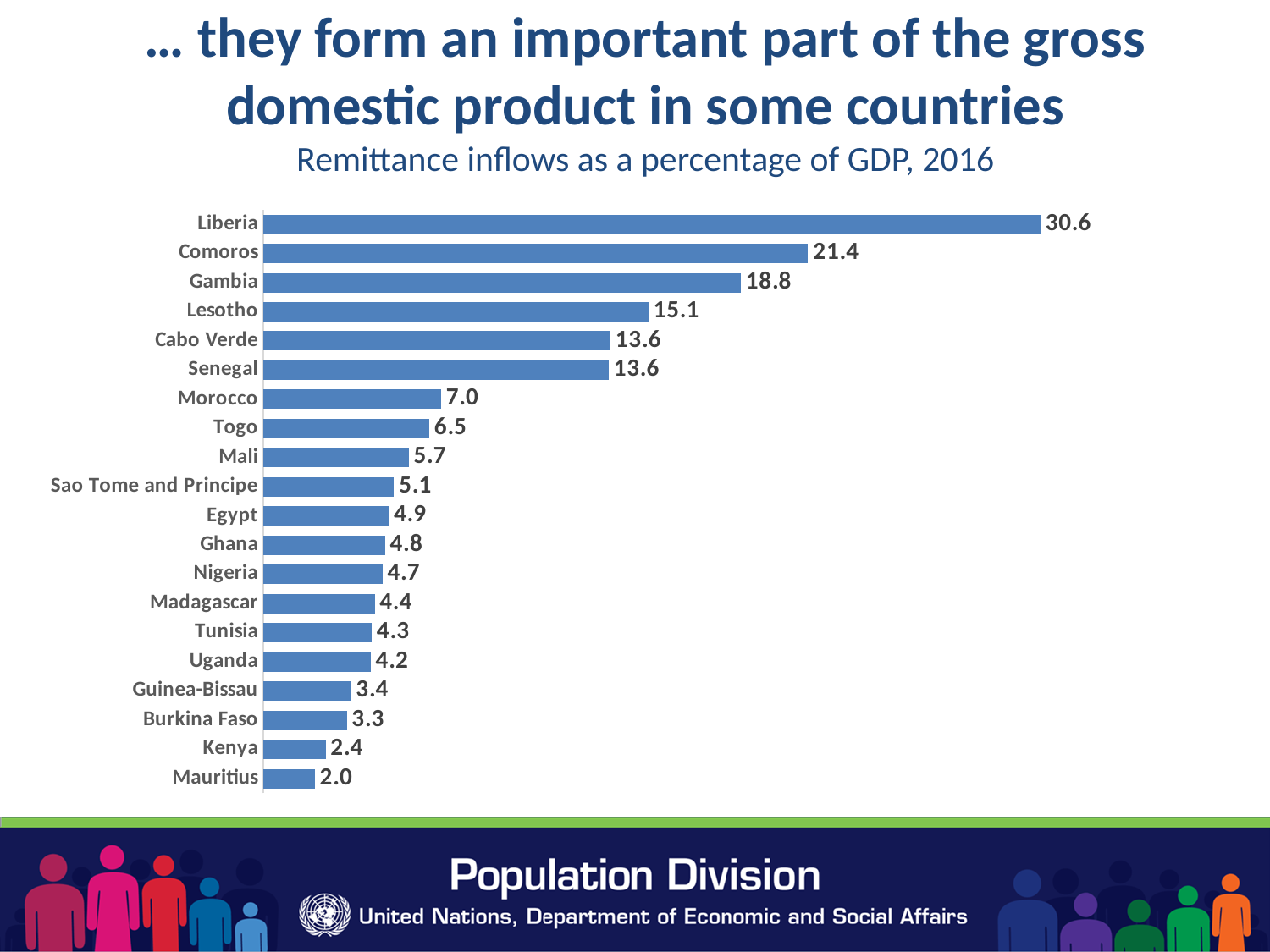
Which country has the highest remittance inflows as a percentage of GDP? Liberia What value is shown for Senegal? 13.6 What is the difference between the values for Liberia and Comoros? 9.2 What value is shown for Sao Tome and Principe? 5.1 What kind of chart is shown on the slide? Bar chart What is the remittance inflow as a percentage of GDP for Liberia? 30.6 How many countries are shown in the chart? 20 What is the subtitle describing the chart's data? Remittance inflows as a percentage of GDP, 2016 Which has a larger value, Kenya or Guinea-Bissau? Guinea-Bissau Which has a larger value, Morocco or Togo? Morocco Which country has the lowest remittance inflows as a percentage of GDP? Mauritius What is the difference between the values for Gambia and Lesotho? 3.7